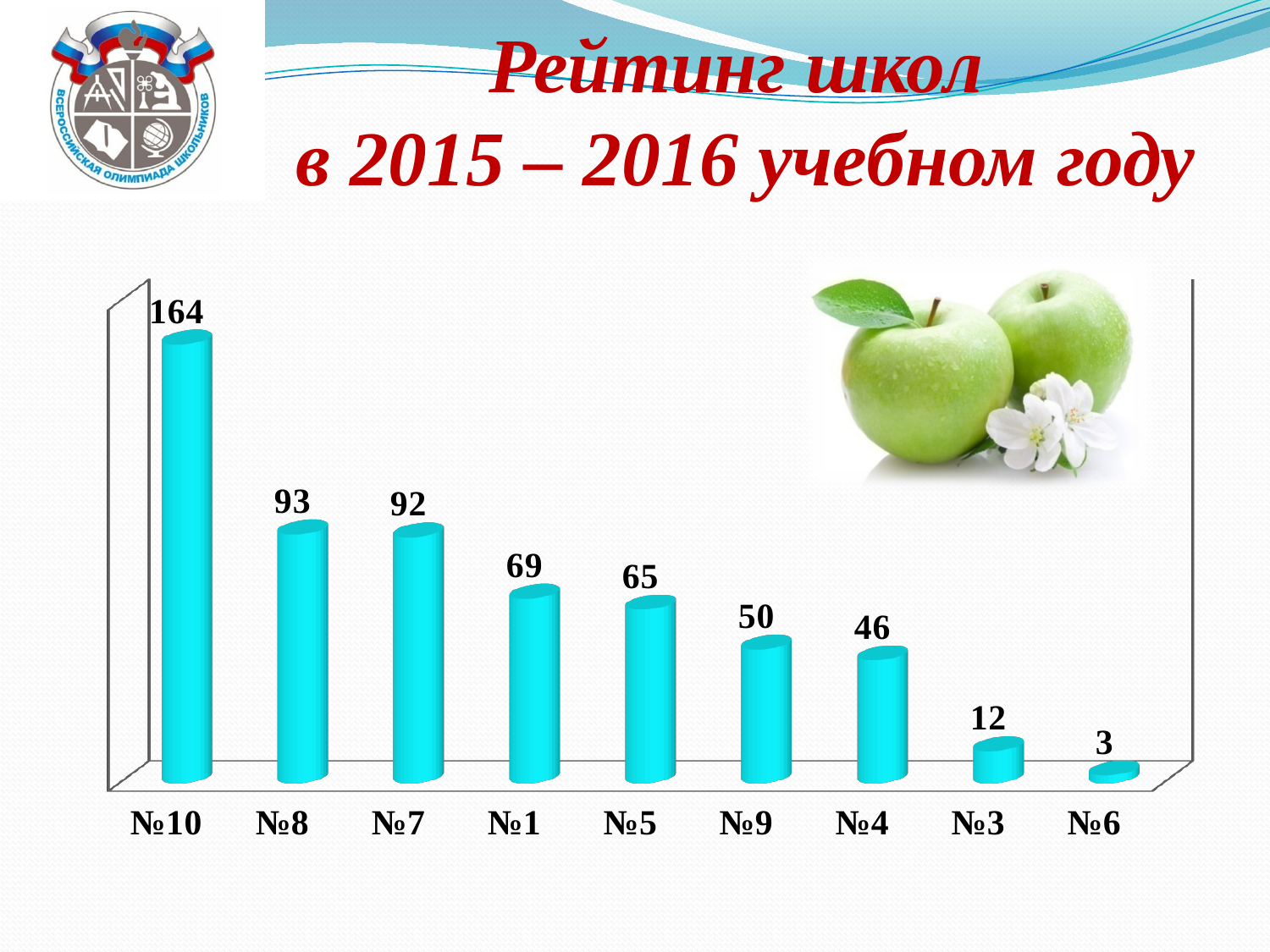
Which school has the highest value? №10 What is the value for school №3? 12 What is the value for school №5? 65 Do the values rise or fall from left to right along the x axis? fall How many schools are shown on the chart? 9 What is the title of the slide? Рейтинг школ в 2015 – 2016 учебном году What is the difference between the values for №9 and №4? 4 What is the difference between the values for №10 and №8? 71 What kind of chart is shown on the slide? bar chart Which school has the lowest value? №6 What is the value for school №10? 164 Which is larger, the value for №1 or the value for №5? №1